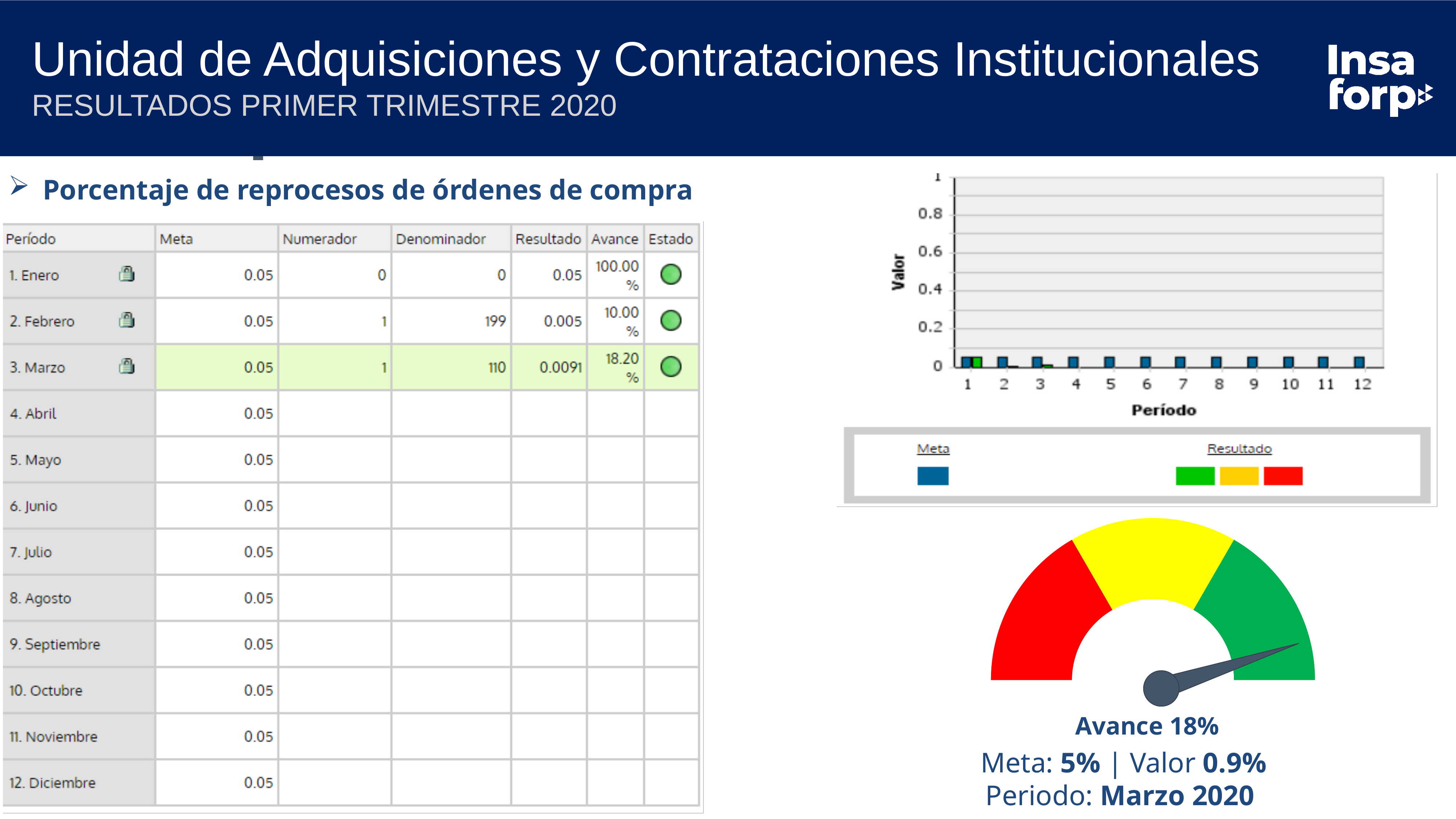
What Meta value is shown below the gauge chart? 5% Which period does the gauge chart refer to? Marzo 2020 What kind of chart is the chart at the top right of the slide? bar chart In the bar chart, is the Meta value for period 1 greater or less than 0.2? less In the bar chart, is the Resultado value for period 3 greater or less than 0.2? less How many periods are shown on the x axis of the bar chart? 12 What Valor is shown below the gauge chart? 0.9% In the bar chart, do the Meta bars rise, fall, or stay flat across periods 1 to 12? stay flat What are the two legend entries of the bar chart? Meta and Resultado What colour are the Meta bars in the bar chart? blue How many series does the legend of the bar chart list? 2 What Avance value is shown below the gauge chart? 18%